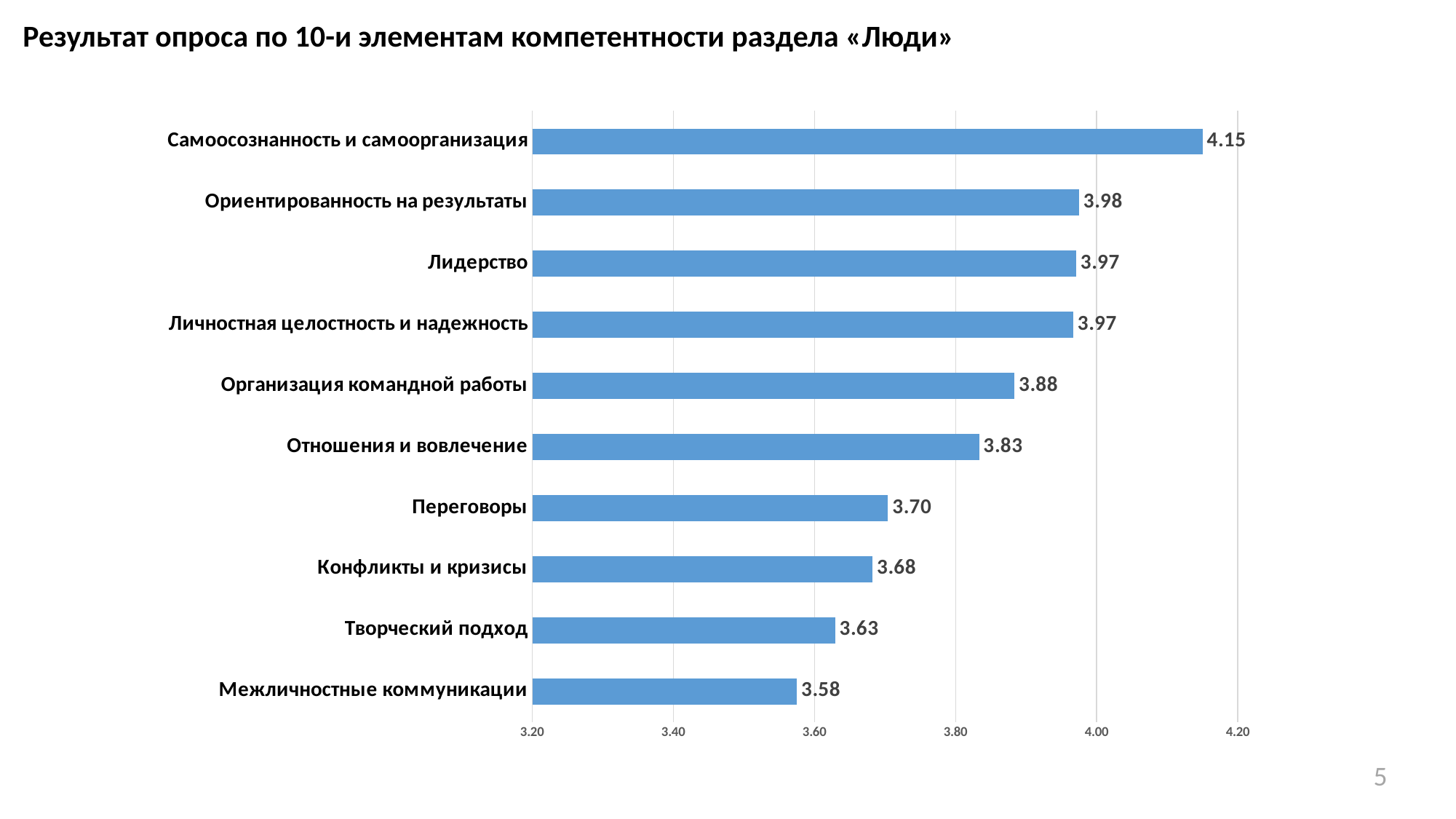
How many categories are shown in the chart? 10 What is the value for Переговоры? 3.70 What is the value for Организация командной работы? 3.88 Is the value for Лидерство greater or less than 4.00? less Which category has the highest value? Самоосознанность и самоорганизация Which category has the lowest value? Межличностные коммуникации What is the difference between the values for Ориентированность на результаты and Отношения и вовлечение? 0.15 What is the value for Самоосознанность и самоорганизация? 4.15 What kind of chart is shown on the slide? bar chart What is the value for Межличностные коммуникации? 3.58 What is the difference between the values for Самоосознанность и самоорганизация and Межличностные коммуникации? 0.57 Which is larger, the value for Конфликты и кризисы or the value for Творческий подход? Конфликты и кризисы